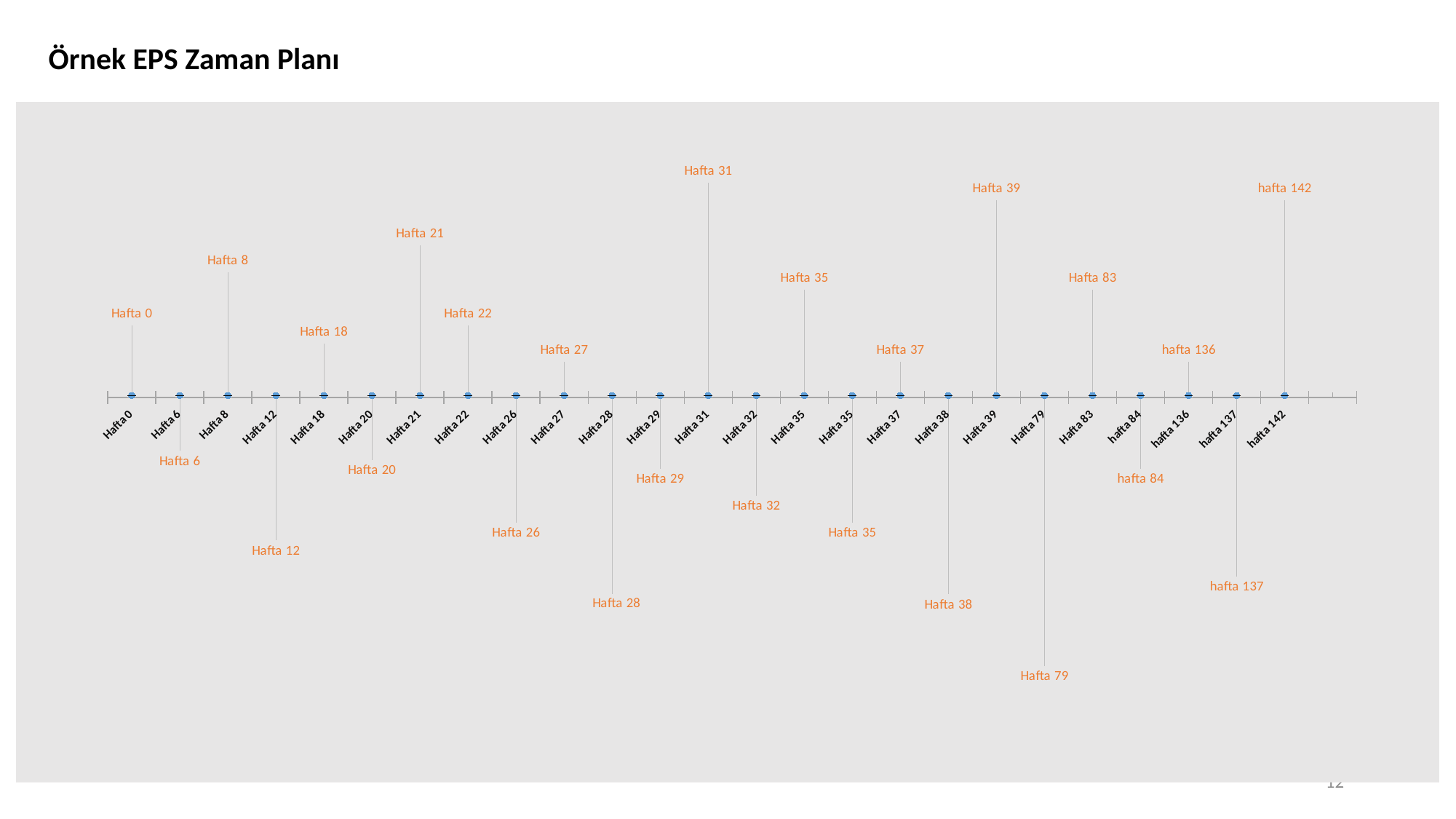
Which milestone is placed between Hafta 8 and Hafta 18 on the timeline? Hafta 12 What is the title of the slide containing the timeline chart? Örnek EPS Zaman Planı Which milestone label is positioned lowest below the timeline axis? Hafta 79 Which milestone comes immediately after Hafta 39 on the timeline? Hafta 79 Which milestone label is positioned highest above the timeline axis? Hafta 31 Which milestone comes immediately before Hafta 136 on the timeline? hafta 84 How many milestone points are plotted on the timeline? 25 What is the label of the first milestone on the left of the timeline? Hafta 0 What kind of chart is shown on the slide? Timeline chart What is the label of the last milestone on the right of the timeline? hafta 142 Do the week numbers of the milestones increase or decrease from left to right along the timeline? Increase